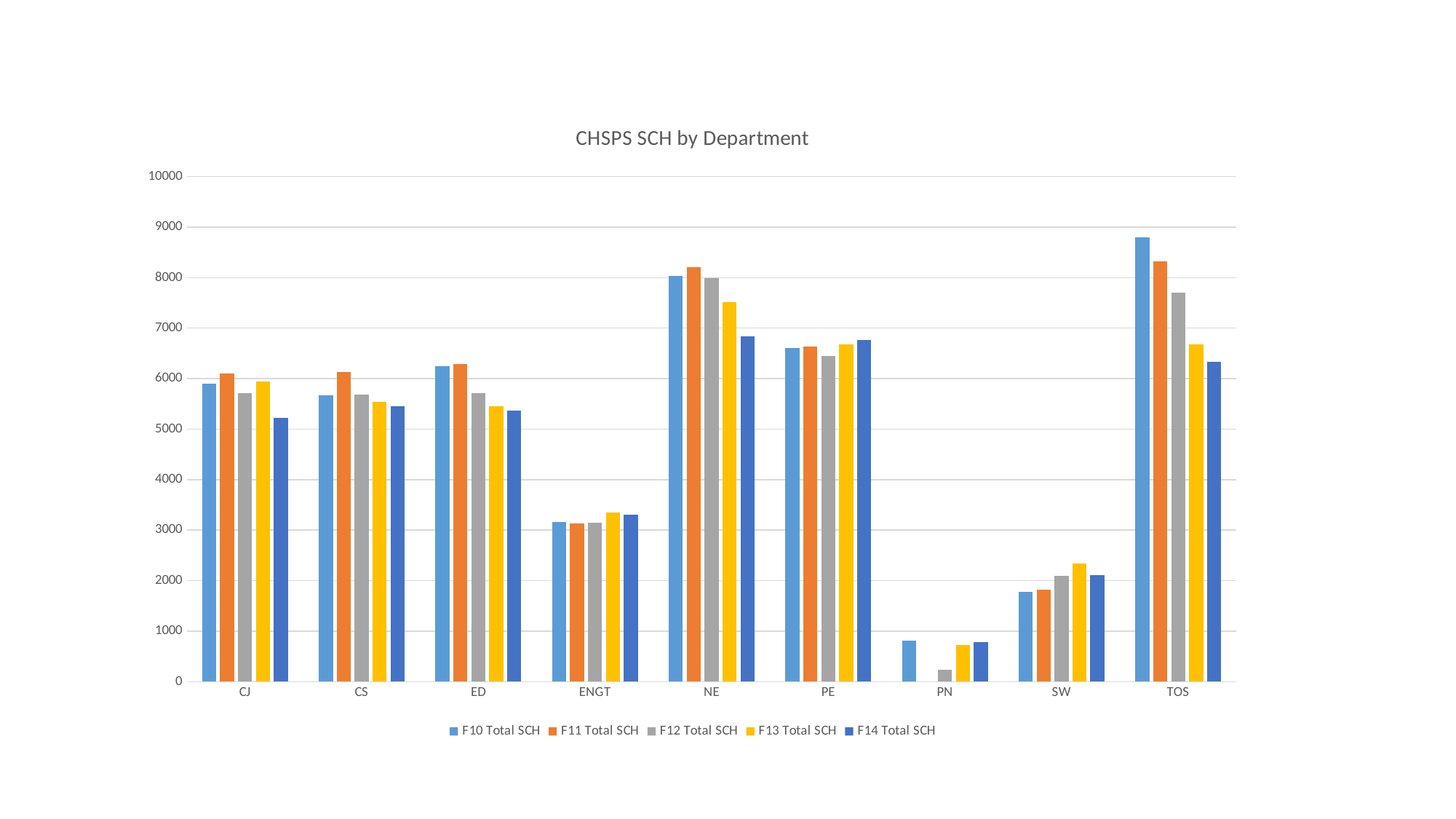
Which department has the lowest F12 Total SCH? PN Is the F10 Total SCH value for TOS greater or less than 8000? greater For TOS, do the values rise or fall from F10 Total SCH to F14 Total SCH? fall Is the F14 Total SCH value for NE greater or less than 7000? less What kind of chart is shown on the slide? bar chart What is the title of the chart? CHSPS SCH by Department How many departments are shown on the x axis? 9 Which is larger, the F13 Total SCH for SW or the F13 Total SCH for PN? SW Which is larger, the F11 Total SCH for NE or the F11 Total SCH for PE? NE Is the F12 Total SCH value for ENGT greater or less than 4000? less How many series does the legend list? 5 Which department has the highest F10 Total SCH? TOS